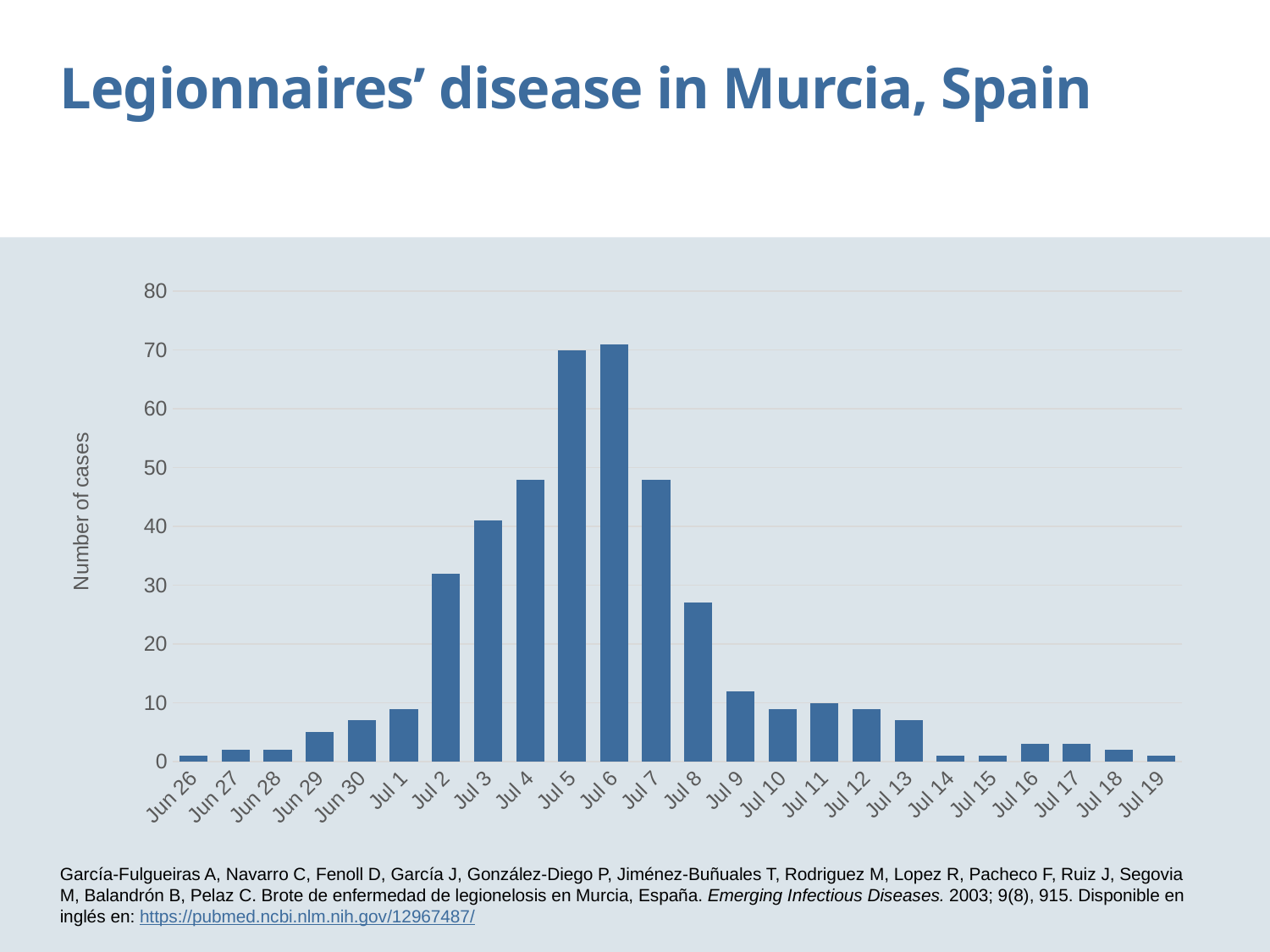
From Jul 6 to Jul 19, do the number of cases generally rise or fall? fall What is the number of cases on Jul 5? 70 What is the label of the y axis? Number of cases Is the number of cases on Jul 8 greater or less than 30? less Which date has more cases, Jul 3 or Jul 9? Jul 3 Is the number of cases on Jul 4 greater or less than 50? less Is the number of cases on Jul 2 greater or less than 30? greater Which date has more cases, Jul 2 or Jul 8? Jul 2 How many dates are plotted along the x axis? 24 What kind of chart is shown on the slide? bar chart